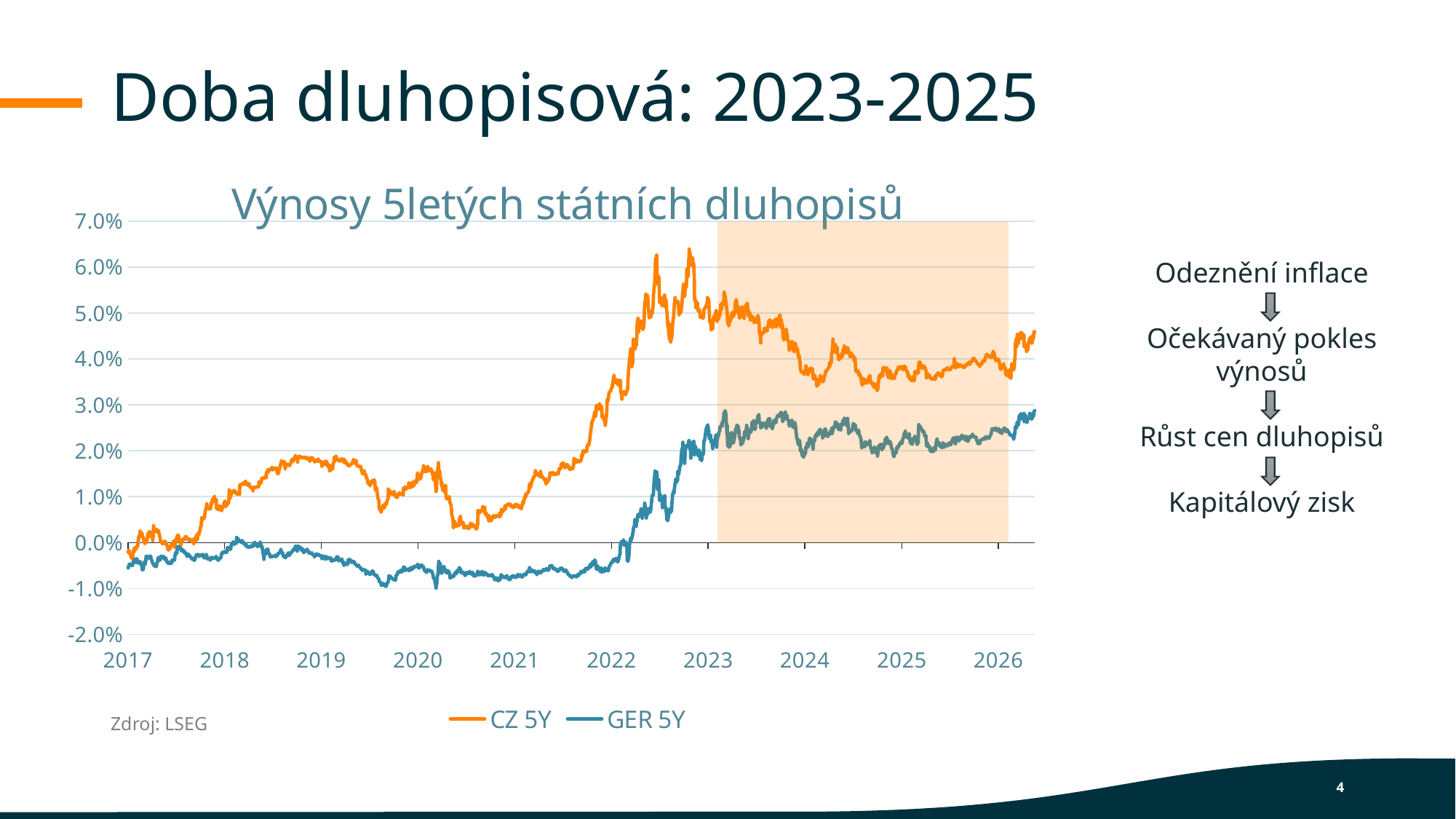
Is the peak value of the CZ 5Y series in 2022 greater or less than 6.0%? greater How many series does the legend of the chart list? 2 Is the value of the CZ 5Y series at the start of 2025 greater or less than 3.0%? greater Which series is drawn in orange in the chart? CZ 5Y Is the value of the GER 5Y series at the start of 2020 greater or less than 0.0%? less What is the title of the chart? Výnosy 5letých státních dluhopisů Does the CZ 5Y series rise or fall between the start of 2020 and the start of 2022? rise How many year labels are shown on the x axis of the chart? 10 What kind of chart is shown on the slide? line chart Which series has the higher value at the start of 2023, CZ 5Y or GER 5Y? CZ 5Y